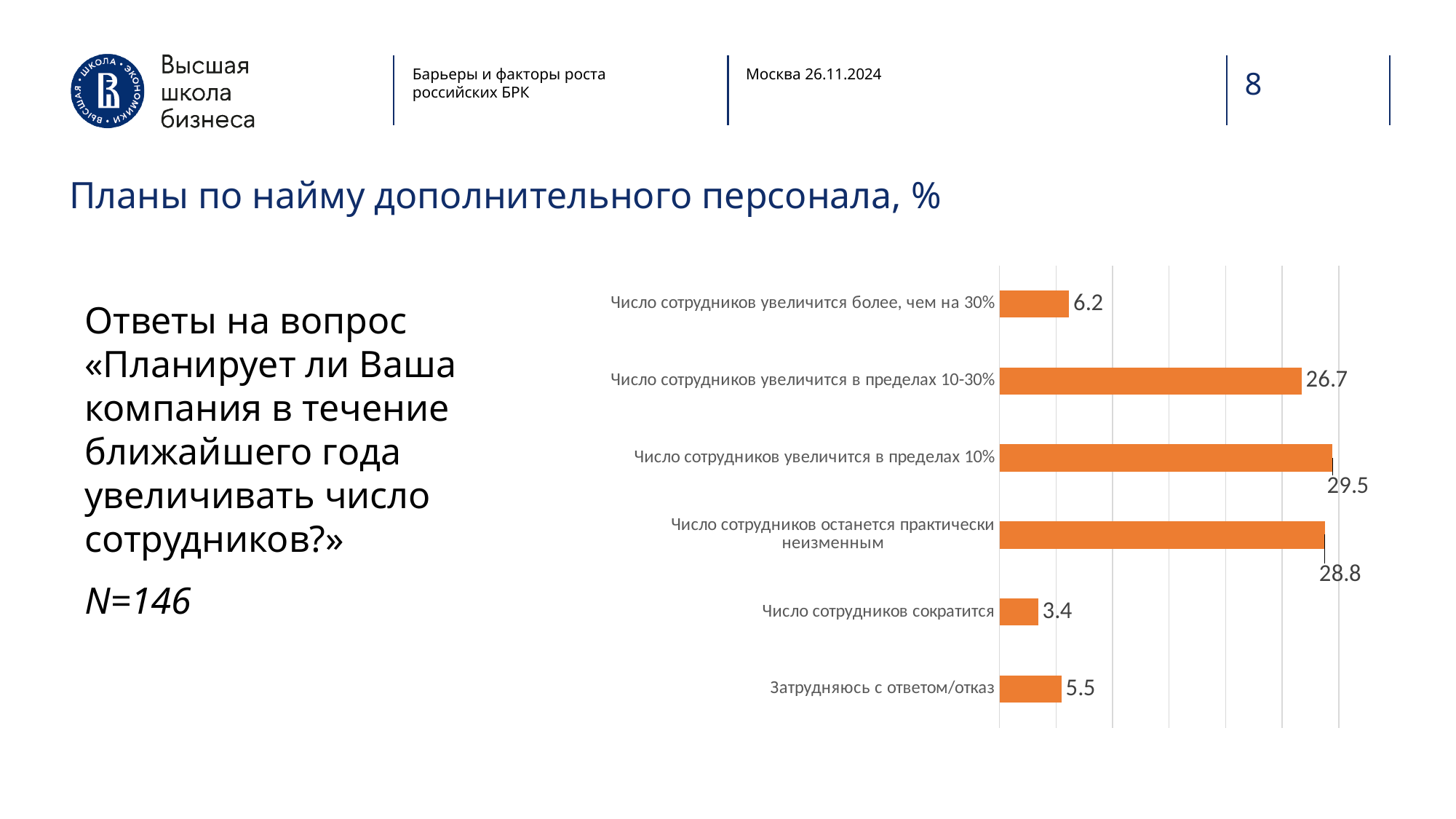
What is the title of the chart on the slide? Планы по найму дополнительного персонала, % What is the difference between the values for «Число сотрудников увеличится в пределах 10%» and «Число сотрудников останется практически неизменным»? 0.7 Which is larger: the value for «Затрудняюсь с ответом/отказ» or the value for «Число сотрудников сократится»? Затрудняюсь с ответом/отказ Which category has the lowest value? Число сотрудников сократится What is the difference between the values for «Число сотрудников увеличится более, чем на 30%» and «Число сотрудников сократится»? 2.8 What value is shown for «Число сотрудников увеличится в пределах 10-30%»? 26.7 What value is shown for «Число сотрудников увеличится более, чем на 30%»? 6.2 What value is shown for «Затрудняюсь с ответом/отказ»? 5.5 Which category has the highest value? Число сотрудников увеличится в пределах 10% How many categories are shown in the chart? 6 What type of chart is shown on the slide? Bar chart What value is shown for «Число сотрудников останется практически неизменным»? 28.8